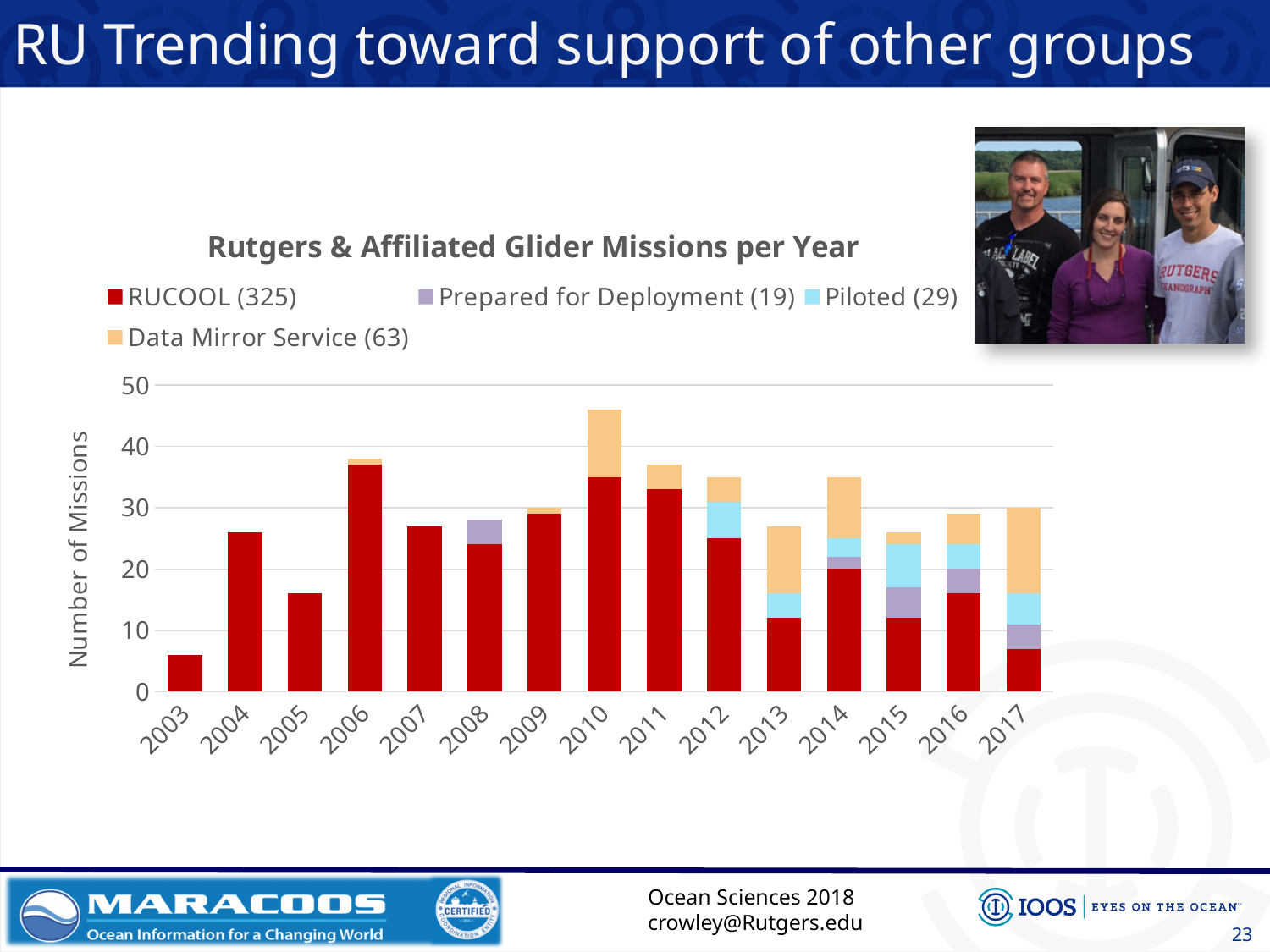
What total number of missions does the legend give for RUCOOL? 325 What is the title of the chart? Rutgers & Affiliated Glider Missions per Year Is the RUCOOL value for 2017 greater or less than 10? less Which year has more total missions, 2004 or 2005? 2004 Which year has the highest total number of missions? 2010 What total number of missions does the legend give for Data Mirror Service? 63 Is the total number of missions in 2003 greater or less than 10? less What type of chart is shown on the slide? stacked bar chart How many years are shown on the x axis of the chart? 15 Which year has the lowest total number of missions? 2003 Is the total number of missions in 2010 greater or less than 40? greater How many series does the chart legend list? 4